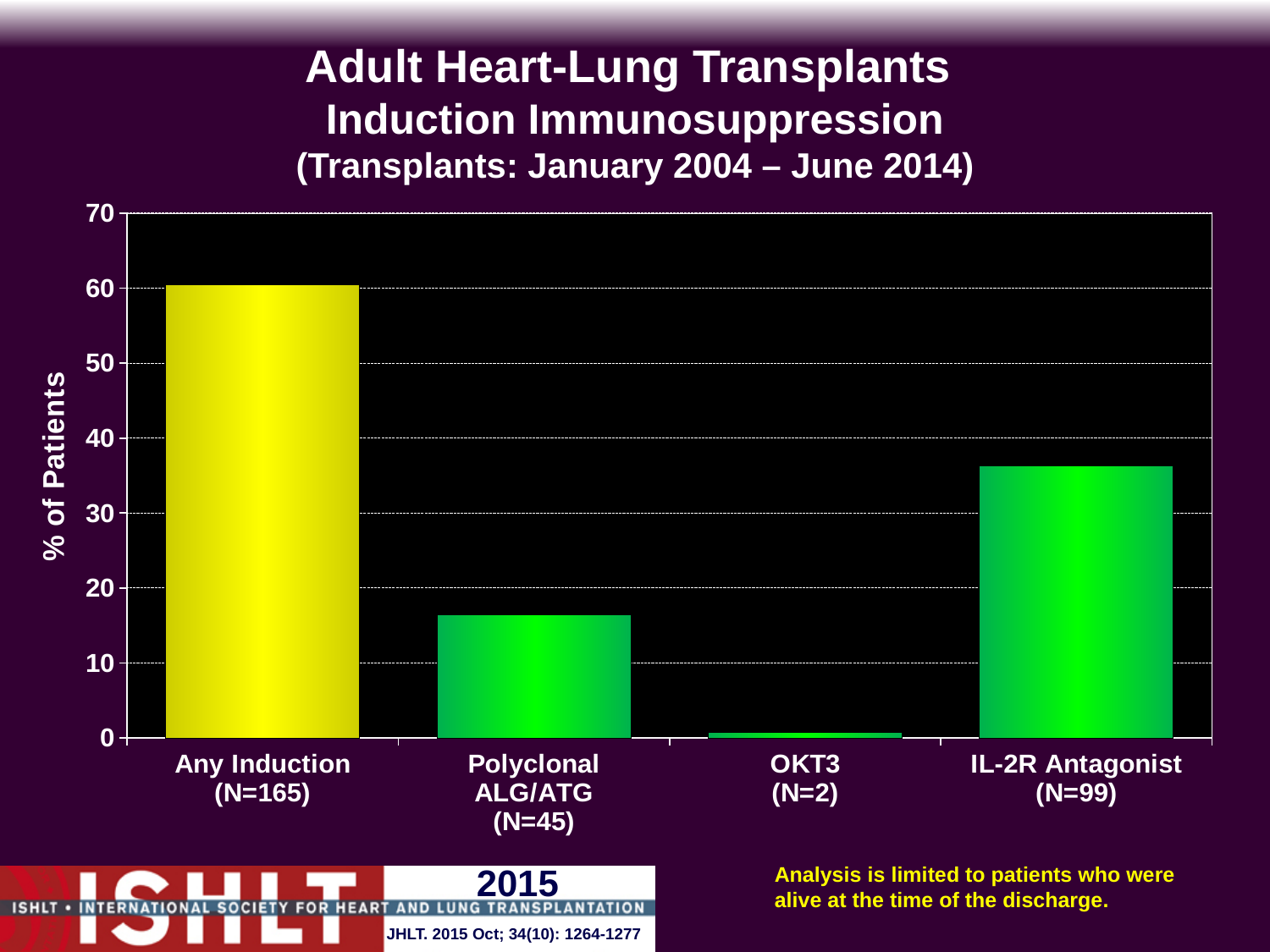
Is the value for Polyclonal ALG/ATG greater or less than 20? less What is the label on the vertical axis of the chart? % of Patients Is the value for OKT3 greater or less than 10? less What kind of chart is shown on the slide? bar chart Is the value for Any Induction greater or less than 50? greater How many categories are plotted on the chart? 4 What is the N shown for the Polyclonal ALG/ATG category? N=45 Which has a higher % of patients, IL-2R Antagonist or Polyclonal ALG/ATG? IL-2R Antagonist Which category has the highest % of patients? Any Induction Which category has the lowest % of patients? OKT3